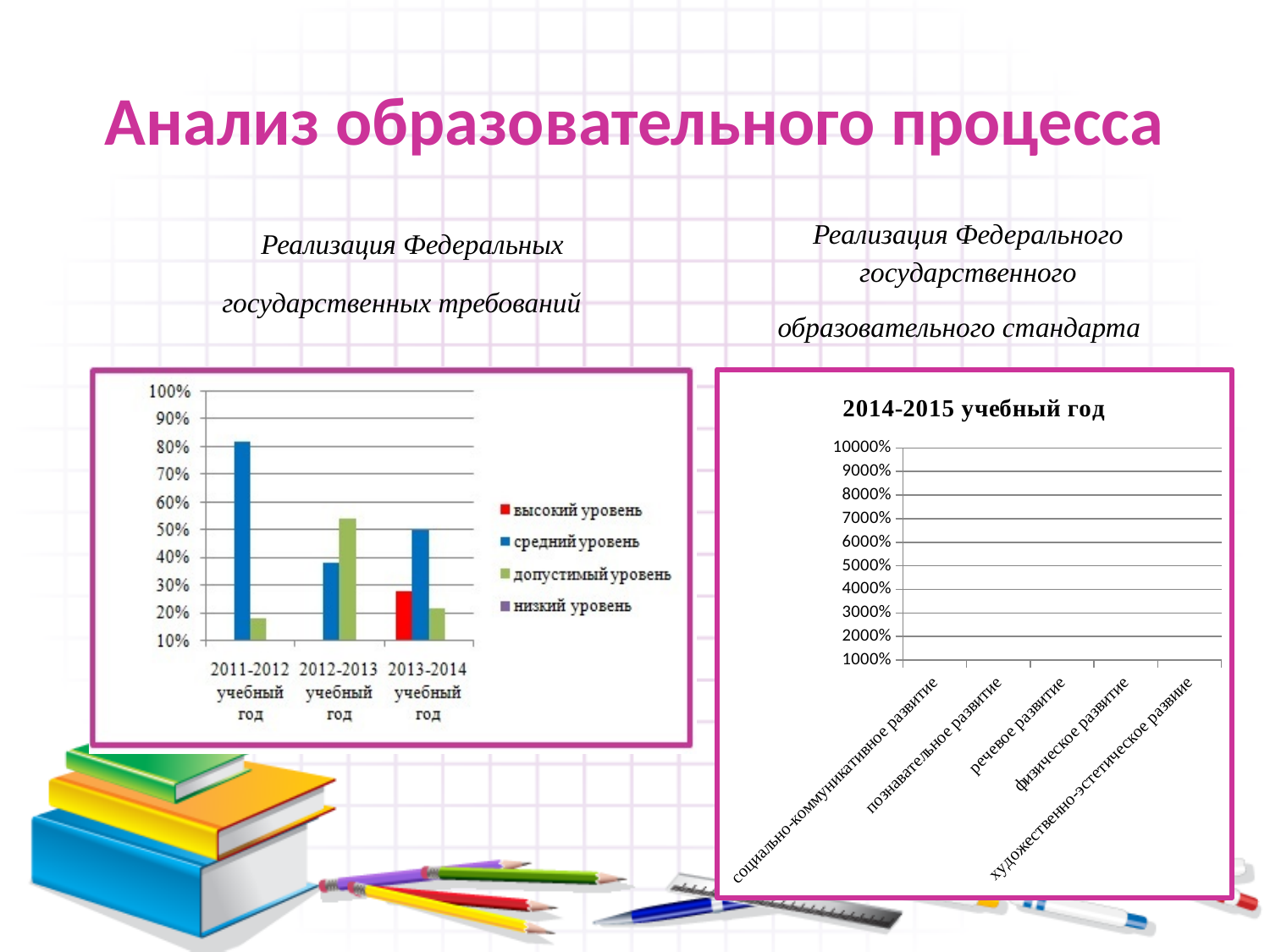
In the left chart, is the value for допустимый уровень in 2011-2012 учебный год greater or less than 30%? less In the left chart, is the value for допустимый уровень in 2012-2013 учебный год greater or less than 50%? greater In the left chart, which is larger in 2013-2014 учебный год: высокий уровень or средний уровень? средний уровень How many series does the legend of the left chart list? 4 In the left chart, in which academic year does the высокий уровень series first appear with a visible bar? 2013-2014 учебный год What is the title of the right chart? 2014-2015 учебный год In the left chart, which is larger in 2012-2013 учебный год: средний уровень or допустимый уровень? допустимый уровень In the left chart, is the value for средний уровень in 2011-2012 учебный год greater or less than 70%? greater How many academic-year categories are shown on the x axis of the left chart? 3 What kind of chart is the left chart (Реализация Федеральных государственных требований)? bar chart How many categories are listed on the x axis of the right chart (2014-2015 учебный год)? 5 In the left chart, in which academic year is the средний уровень bar highest? 2011-2012 учебный год